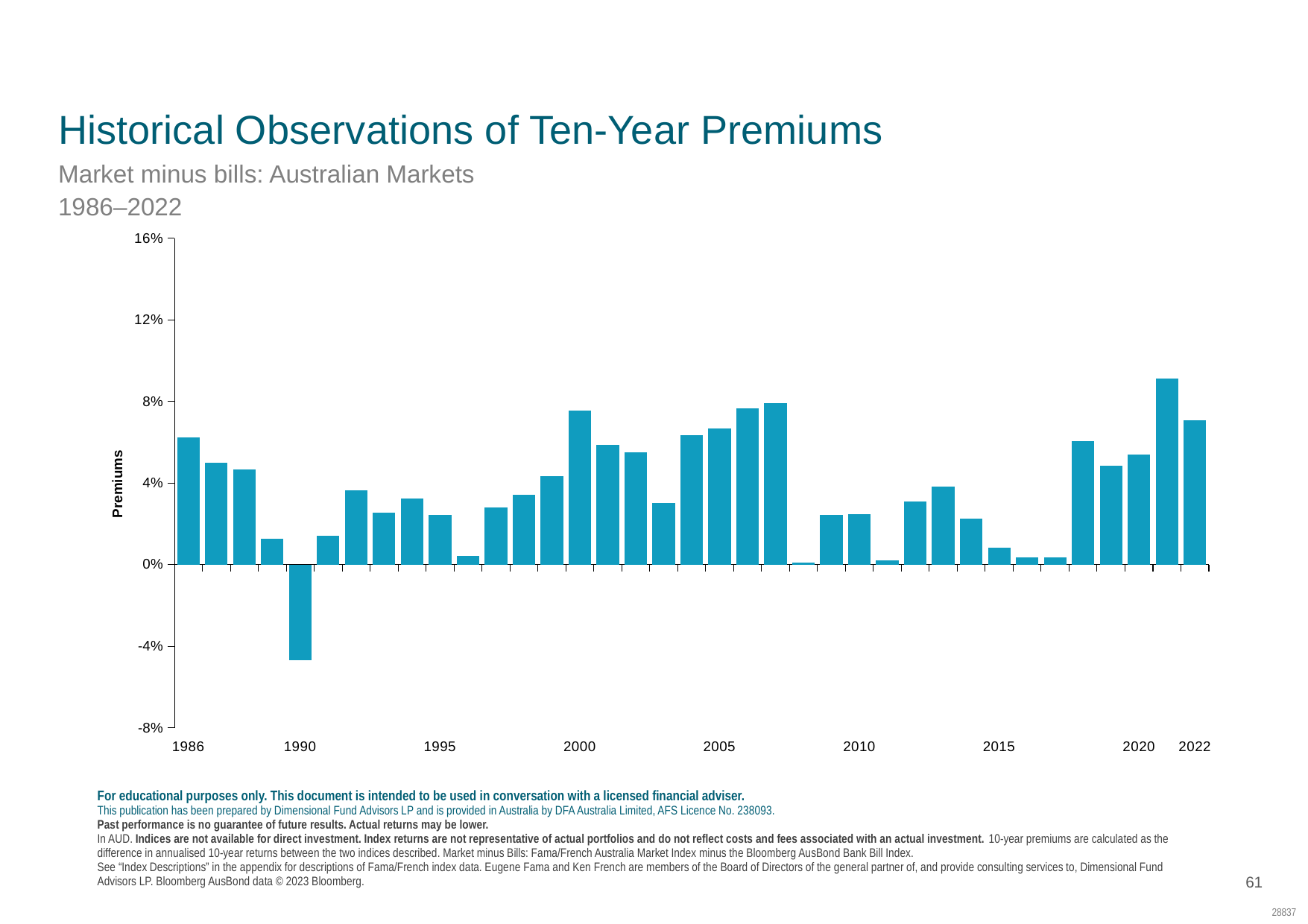
Which year has the lowest ten-year premium in the chart? 1990 Is the value for 1990 greater or less than 0%? less What is the label on the vertical axis of the chart? Premiums Is the value for 1986 greater or less than 4%? greater Which year has the highest ten-year premium in the chart? 2021 How many years (bars) are plotted in the chart? 37 Is the value for 2020 greater or less than 4%? greater Which year has the larger premium, 1995 or 2000? 2000 What kind of chart is shown on the slide? Bar chart Which year has the larger premium, 2010 or 2020? 2020